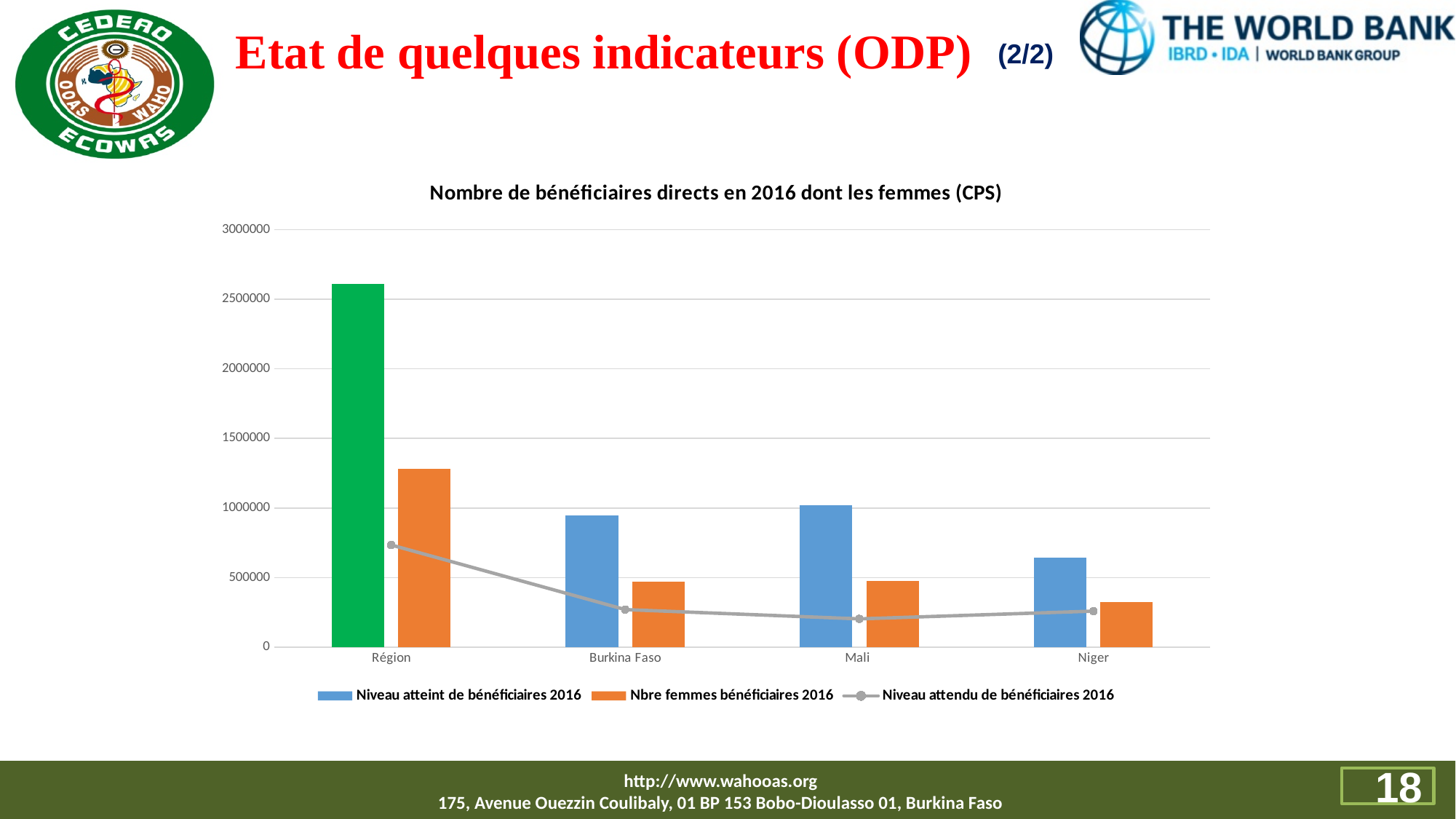
Is the 'Niveau atteint de bénéficiaires 2016' value for Région greater or less than 2000000? greater Which category has the lowest value for 'Nbre femmes bénéficiaires 2016'? Niger Is the 'Niveau atteint de bénéficiaires 2016' value for Burkina Faso greater or less than 1000000? less Is the 'Nbre femmes bénéficiaires 2016' value for Région greater or less than 1000000? greater How many series does the chart legend list? 3 Does the 'Niveau attendu de bénéficiaires 2016' line rise or fall from Région to Burkina Faso? fall Which category has the highest value for 'Niveau atteint de bénéficiaires 2016'? Région Which is larger: the 'Nbre femmes bénéficiaires 2016' value for Région or the 'Niveau atteint de bénéficiaires 2016' value for Burkina Faso? Nbre femmes bénéficiaires 2016 for Région How many categories are shown on the x axis of the chart? 4 What kind of chart is this? Bar chart with a line series What is the title of the chart? Nombre de bénéficiaires directs en 2016 dont les femmes (CPS)